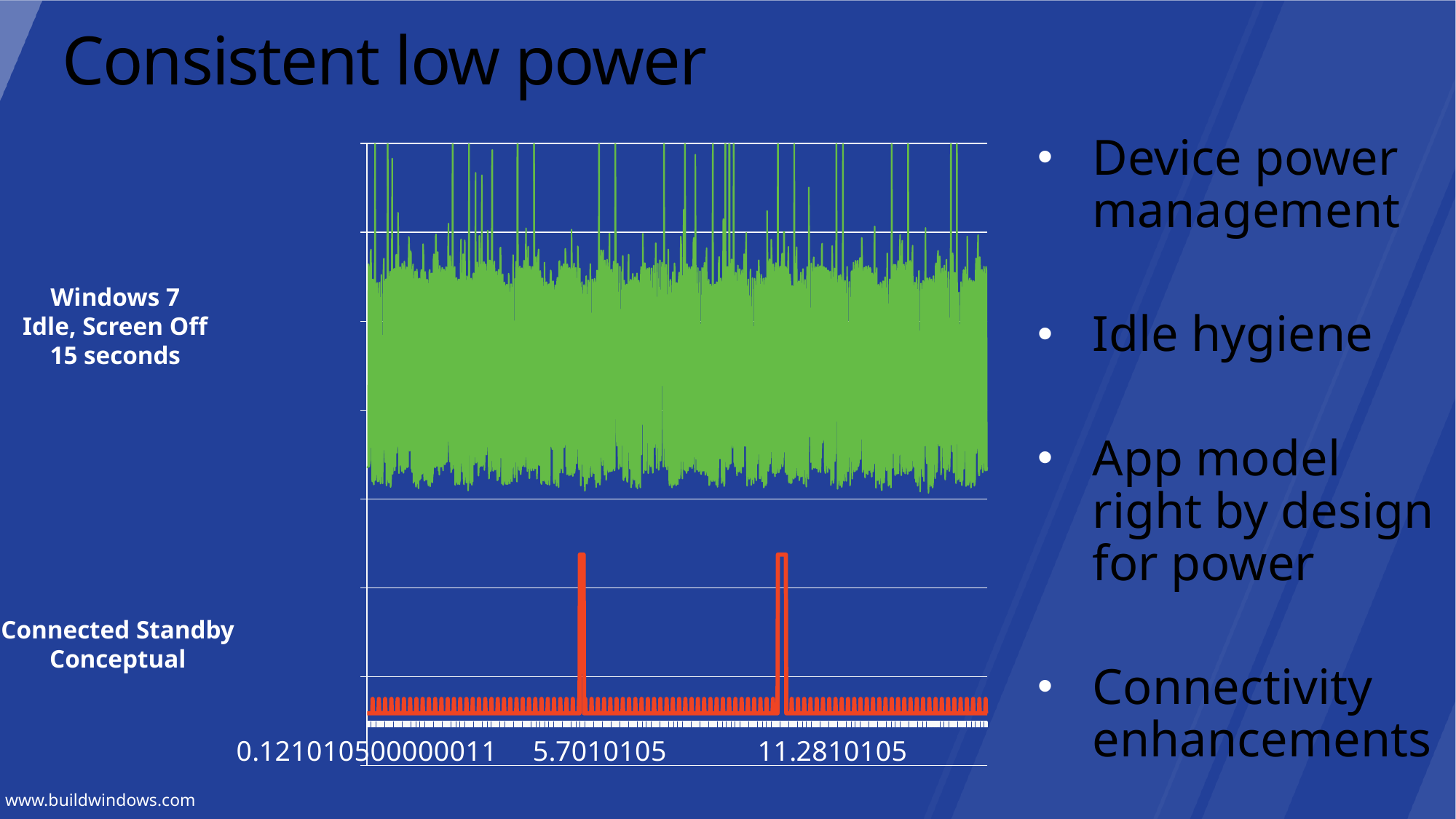
Which series shows the lowest power level on the chart? Connected Standby Conceptual How many labels are printed on the x axis of the chart? 3 Which series shows the higher power level overall, Windows 7 Idle, Screen Off or Connected Standby Conceptual? Windows 7 Idle, Screen Off What kind of chart is shown on the slide? line chart How many large spikes appear in the red Connected Standby Conceptual trace? 2 How many data series are plotted on the chart? 2 Which series is drawn in red on the chart? Connected Standby Conceptual What colour is the Windows 7 Idle, Screen Off trace? green What is the rightmost label on the x axis of the chart? 11.2810105 What is the middle label on the x axis of the chart? 5.7010105